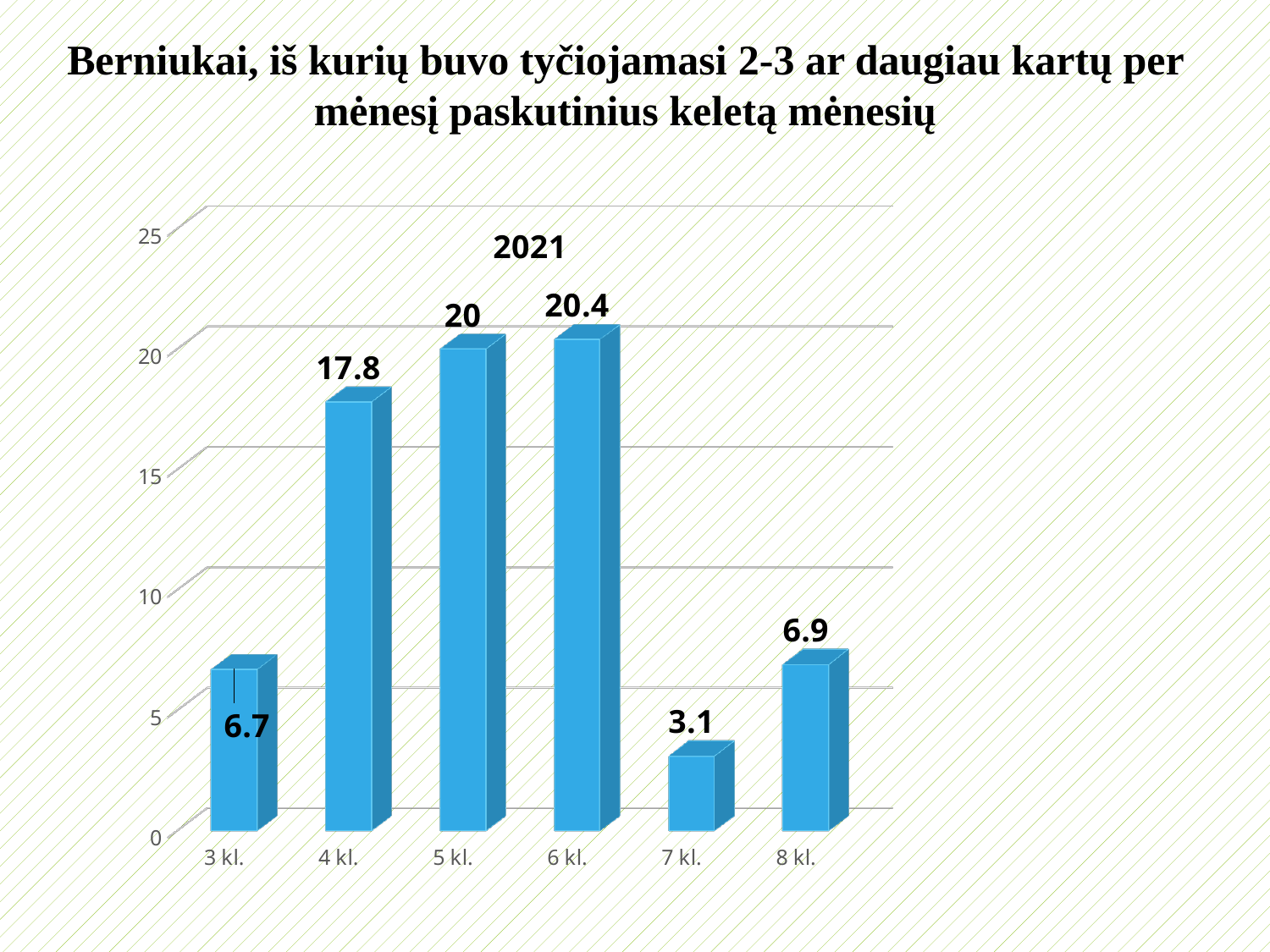
What is the value for 7 kl.? 3.1 Which is larger, the value for 3 kl. or the value for 8 kl.? 8 kl. What is the difference between the values for 6 kl. and 7 kl.? 17.3 What year is labelled on the chart? 2021 Which class has the highest value? 6 kl. Is the value for 4 kl. greater or less than 15? greater How many classes are shown on the x axis? 6 What kind of chart is shown on the slide? bar chart Which class has the lowest value? 7 kl. What is the value for 8 kl.? 6.9 What is the difference between the values for 5 kl. and 4 kl.? 2.2 What is the value for 4 kl.? 17.8